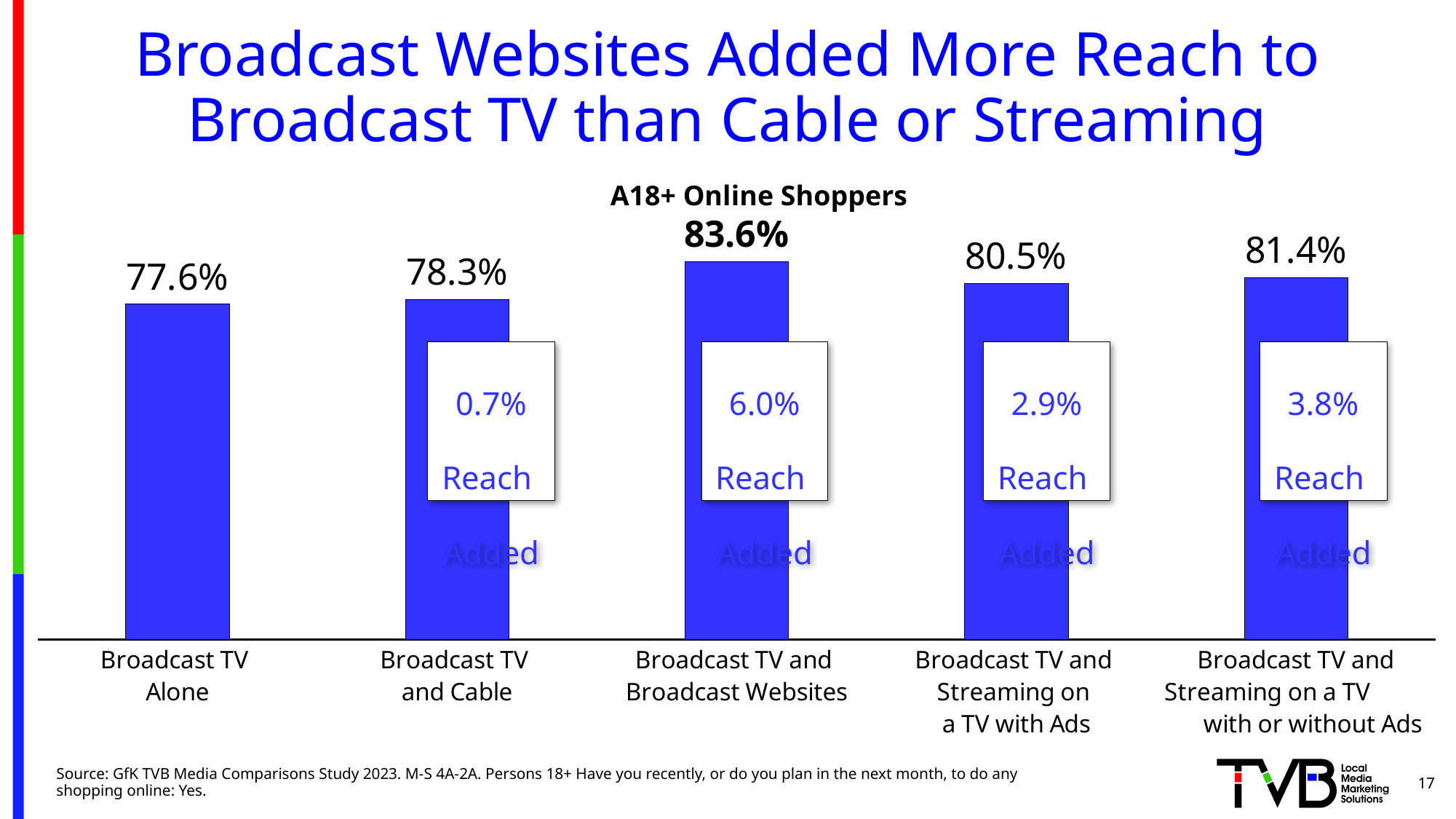
Which category has the lowest value? Broadcast TV Alone What is the value for Broadcast TV and Broadcast Websites? 83.6% What is the value for Broadcast TV and Streaming on a TV with Ads? 80.5% What is the value for Broadcast TV Alone? 77.6% How many categories are shown in the chart? 5 How much reach was added by Broadcast TV and Cable over Broadcast TV Alone, according to the label on the bar? 0.7% What is the value for Broadcast TV and Cable? 78.3% Which is larger: Broadcast TV and Streaming on a TV with or without Ads, or Broadcast TV and Streaming on a TV with Ads? Broadcast TV and Streaming on a TV with or without Ads What kind of chart is this? Bar chart What is the difference between Broadcast TV and Broadcast Websites and Broadcast TV Alone? 6.0% Which category has the highest value? Broadcast TV and Broadcast Websites What is the chart's title? A18+ Online Shoppers